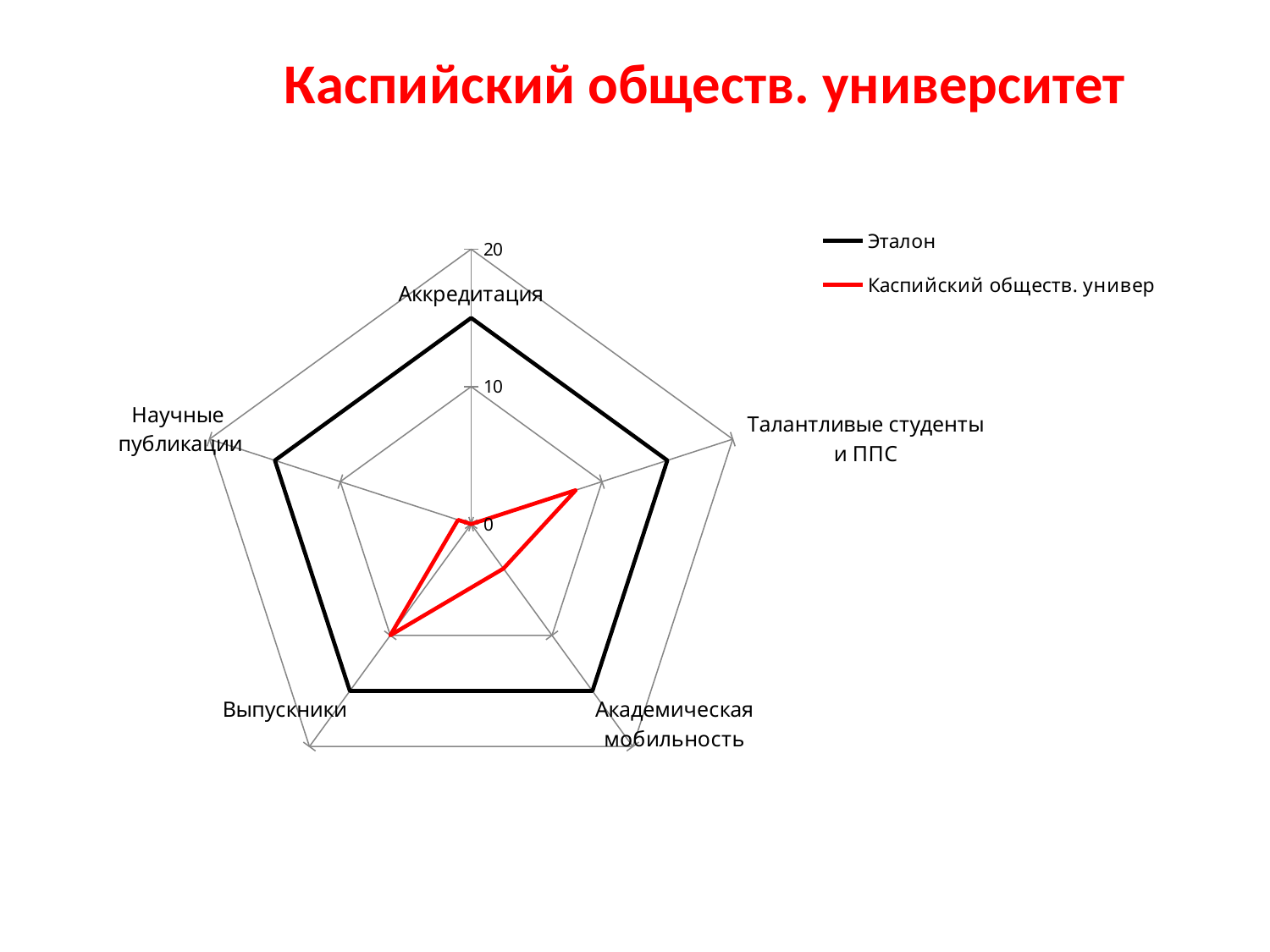
Which series has the larger value for Аккредитация, Эталон or Каспийский обществ. универ? Эталон Which colour is used for the Эталон series? Black Is the Эталон value for Аккредитация greater or less than 10? greater What kind of chart is shown on the slide? Radar chart What is the highest value shown on the chart's axis scale? 20 How many categories (axes) does the radar chart have? 5 Is the Каспийский обществ. универ value for Академическая мобильность greater or less than 10? less Which series has the larger value for Выпускники, Эталон or Каспийский обществ. универ? Эталон How many series does the legend list? 2 Is the Каспийский обществ. универ value for Научные публикации greater or less than 10? less For the Каспийский обществ. универ series, which is larger: the value for Талантливые студенты и ППС or the value for Академическая мобильность? Талантливые студенты и ППС